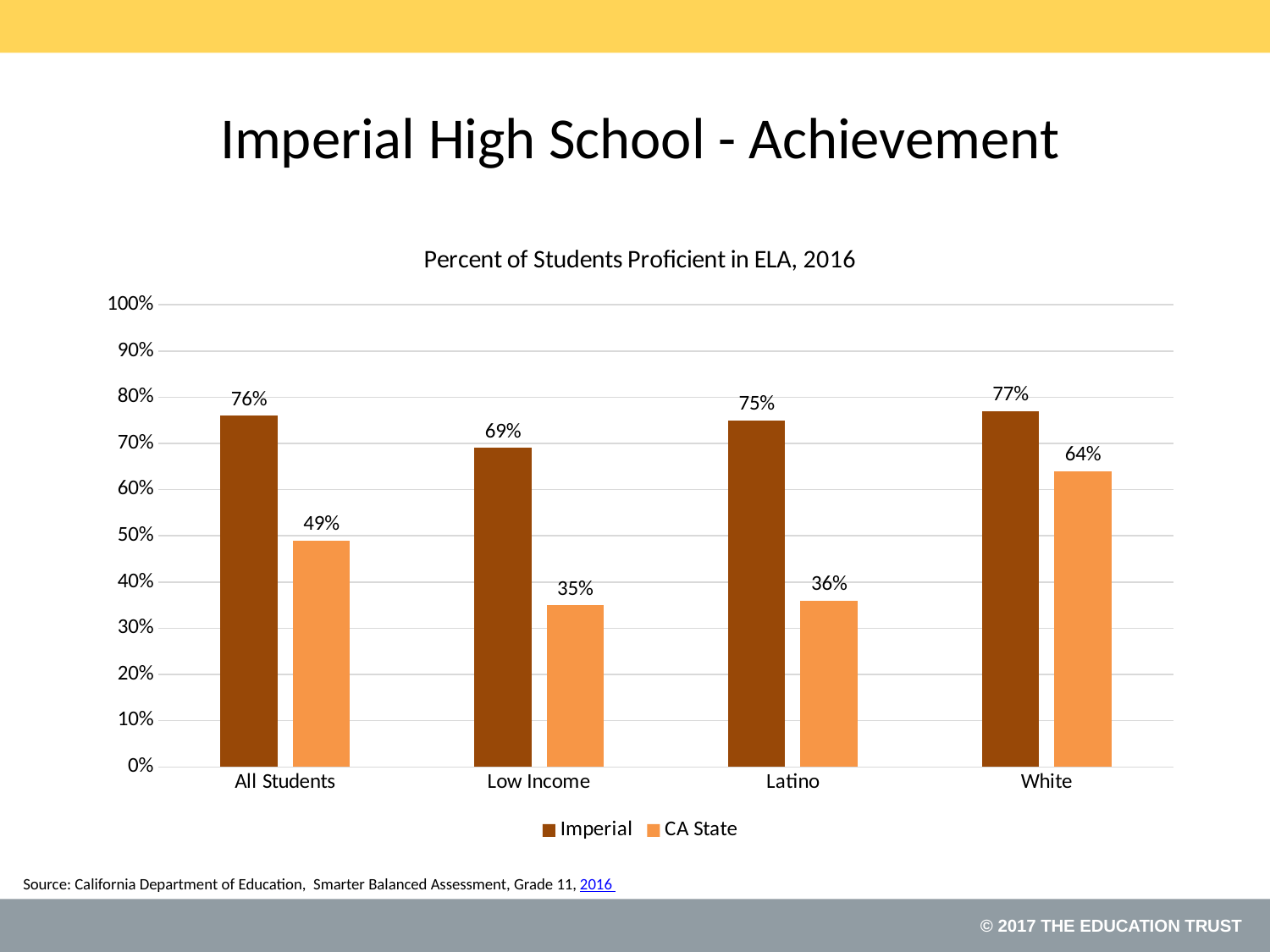
What kind of chart is shown on the slide? bar chart Which is larger for All Students, the Imperial value or the CA State value? Imperial How many categories are shown on the x axis? 4 Is the CA State value for All Students greater or less than 40%? greater What is the CA State value for Latino? 36% How many series does the legend list? 2 Which category has the highest Imperial value? White What is the CA State value for White? 64% What is the title of the chart? Percent of Students Proficient in ELA, 2016 What is the difference between the Imperial and CA State values for Low Income? 34% Which category has the lowest CA State value? Low Income What is the Imperial value for Low Income? 69%